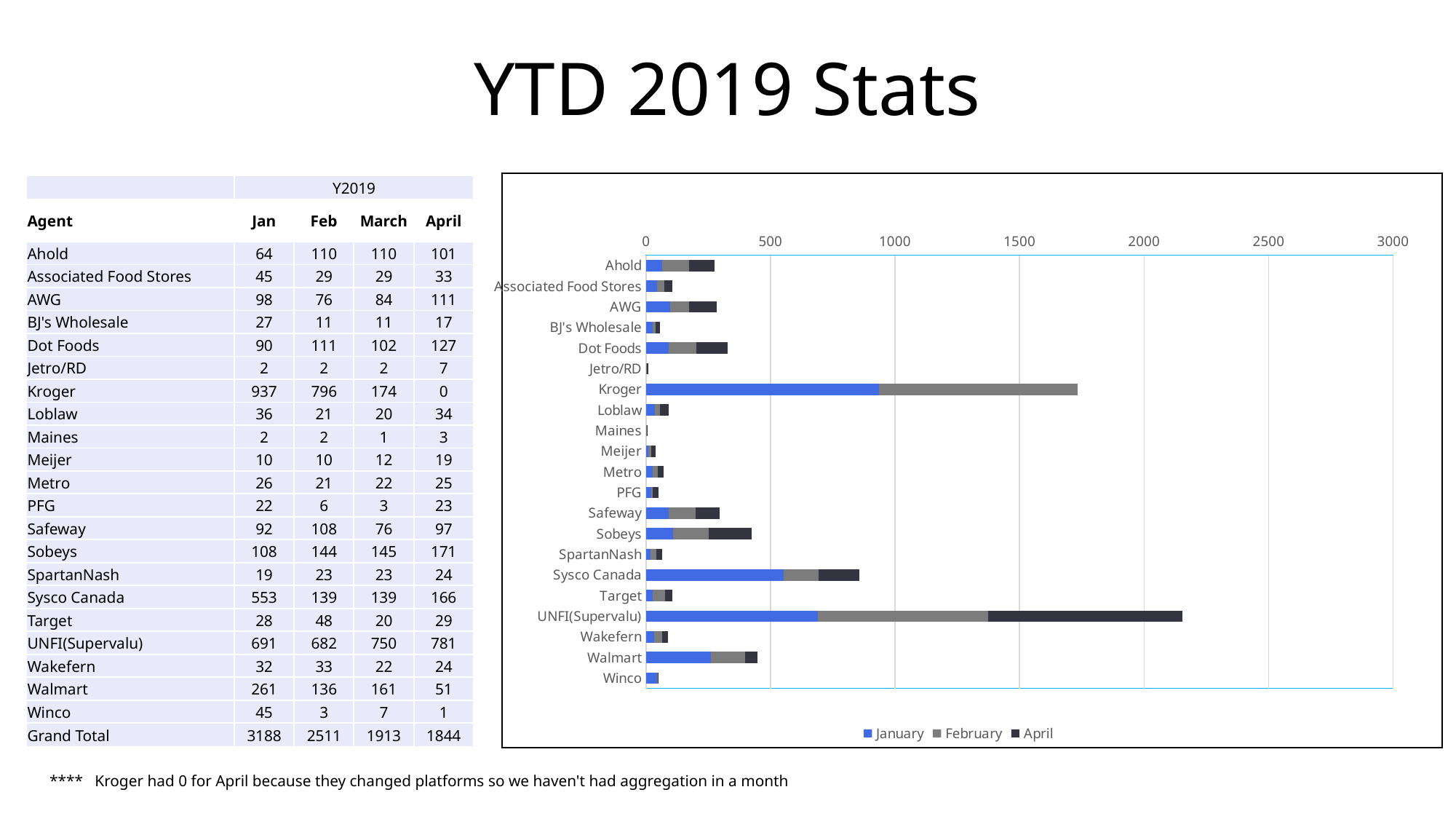
How many series does the chart's legend list? 3 What is the January value for Kroger? 937 What is the difference between the January values for Kroger and UNFI(Supervalu)? 246 How many agents are plotted on the chart? 21 Is the total stacked bar for Sysco Canada greater or less than 1000? less What kind of chart is shown on the slide? Stacked bar chart What is the April value for UNFI(Supervalu)? 781 Is the total stacked bar for Kroger greater or less than 1500? greater Which agent has the largest January value? Kroger Which agent has the longest stacked bar in the chart? UNFI(Supervalu) Which months are listed in the chart's legend? January, February, April What is the total of the stacked bar for UNFI(Supervalu) (January + February + April)? 2154